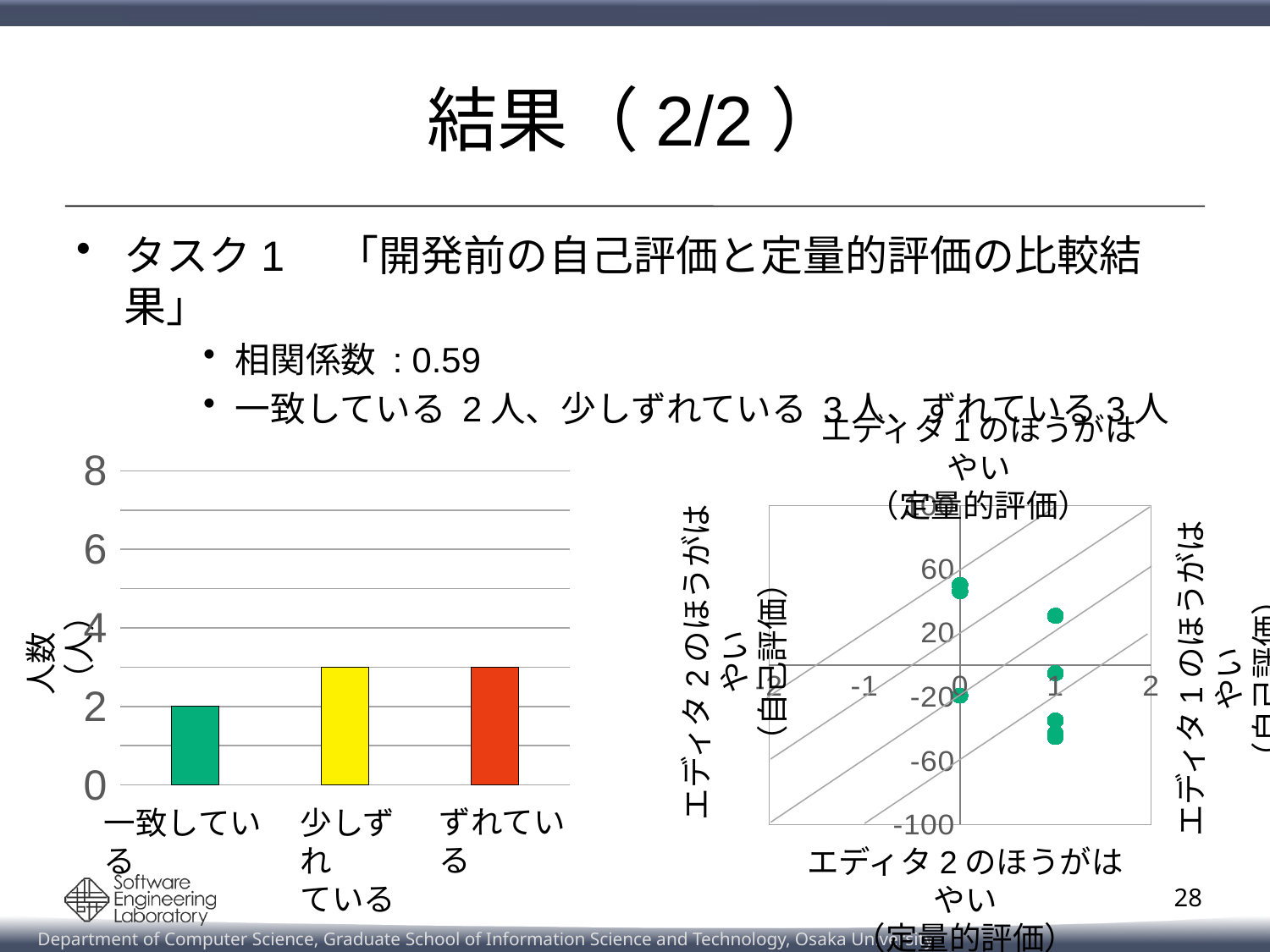
In the bar chart on the left, what colour is the bar for ずれている? red In the bar chart on the left, what is the value for 少しずれている? 3 In the bar chart on the left, which is larger, the value for ずれている or the value for 一致している? ずれている In the bar chart on the left, what is the value for 一致している? 2 In the bar chart on the left, what is the value for ずれている? 3 In the bar chart on the left, what is the label of the vertical axis? 人数(人) What kind of chart is the chart on the right of the slide? scatter plot In the bar chart on the left, which category has the lowest value? 一致している What kind of chart is the chart on the left of the slide? bar chart How many categories are shown in the bar chart on the left? 3 In the bar chart on the left, what is the difference between the values for 少しずれている and 一致している? 1 In the bar chart on the left, is the value for 少しずれている greater or less than 4? less